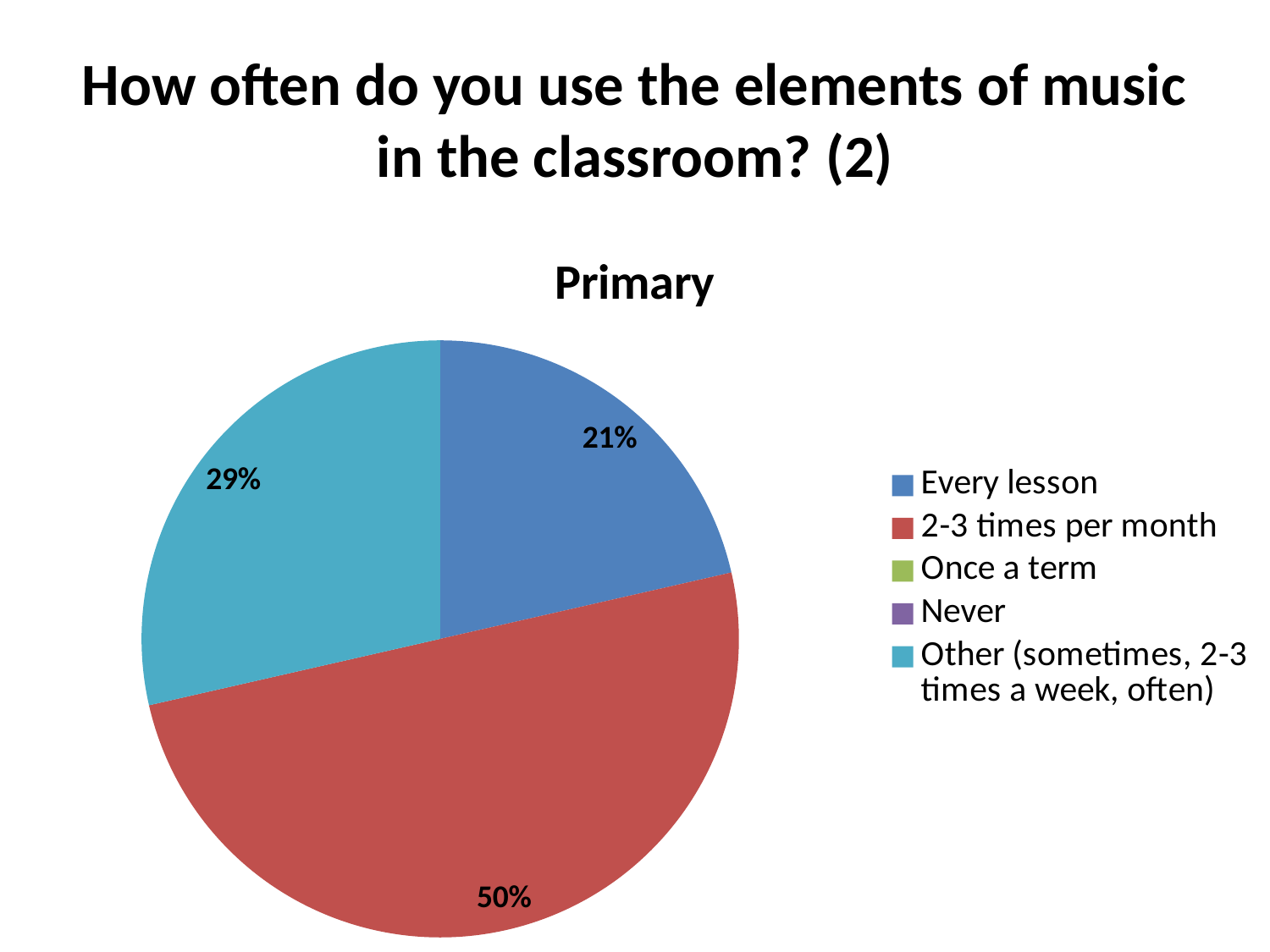
What colour is the '2-3 times per month' slice? red What is the difference between the '2-3 times per month' share and the 'Every lesson' share? 29% What type of chart is shown on the slide? pie chart What percentage of the pie is 'Every lesson'? 21% Which of the labelled slices has the smallest share of the pie? Every lesson Which is larger: the share for 'Other (sometimes, 2-3 times a week, often)' or the share for 'Every lesson'? Other (sometimes, 2-3 times a week, often) What is the difference between the 'Other (sometimes, 2-3 times a week, often)' share and the 'Every lesson' share? 8% What is the chart's title? Primary How many entries does the legend list? 5 Which category has the largest share of the pie? 2-3 times per month What percentage of the pie is '2-3 times per month'? 50% What percentage of the pie is 'Other (sometimes, 2-3 times a week, often)'? 29%